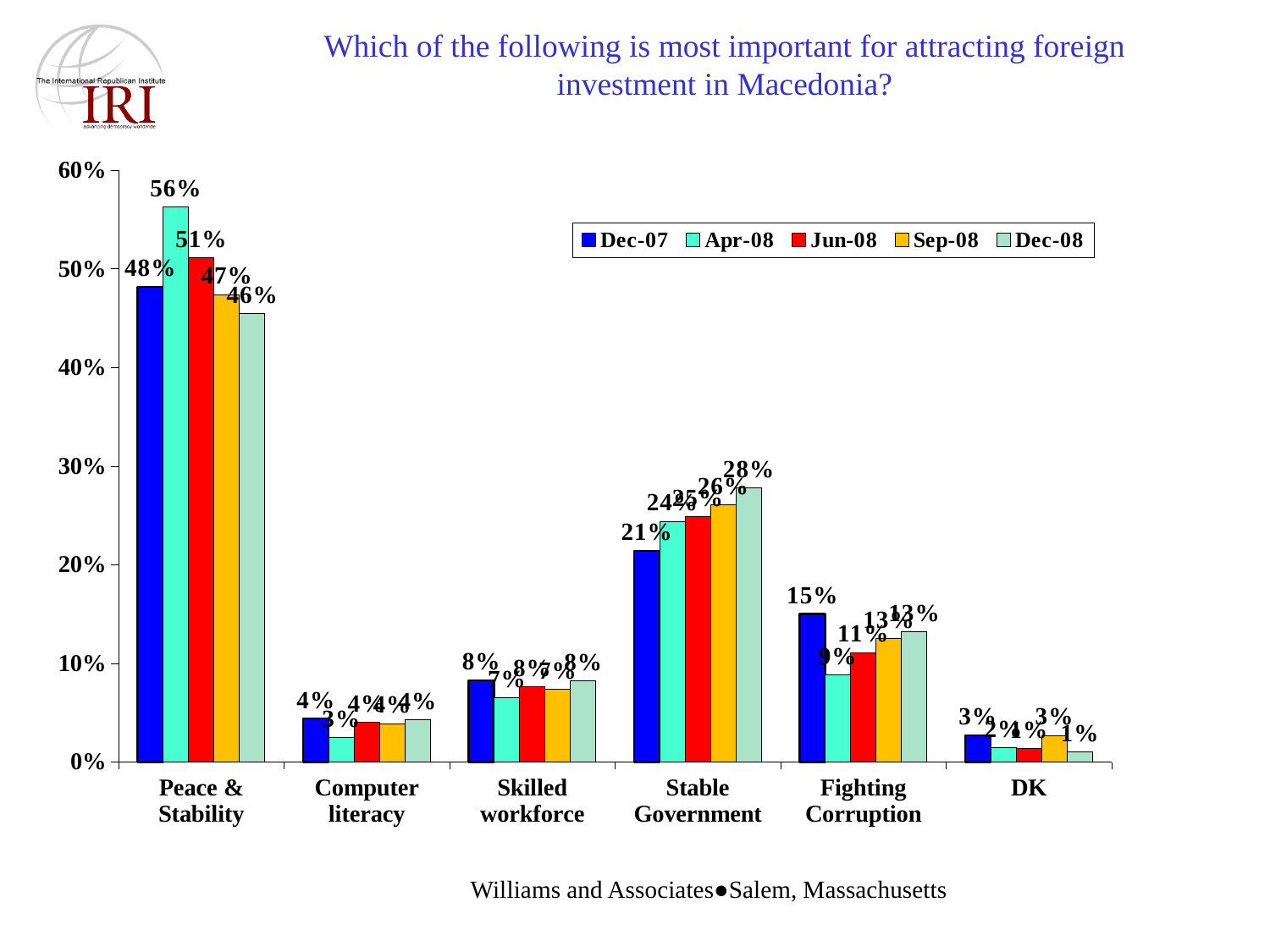
Do the values for Stable Government rise or fall from Dec-07 to Dec-08? rise Is the value for Stable Government in the Apr-08 series greater or less than 20%? greater What is the value for Peace & Stability in the Apr-08 series? 56% In the Dec-07 series, which is larger: Stable Government or Fighting Corruption? Stable Government What is the value for Stable Government in the Dec-08 series? 28% How many series does the legend list? 5 What is the value for Fighting Corruption in the Dec-07 series? 15% What kind of chart is shown on the slide? bar chart How many categories are shown on the x axis? 6 What is the difference between the Apr-08 and Dec-08 values for Peace & Stability? 10 percentage points Which series has the lowest value for Peace & Stability? Dec-08 Which category has the highest value in the Dec-07 series? Peace & Stability